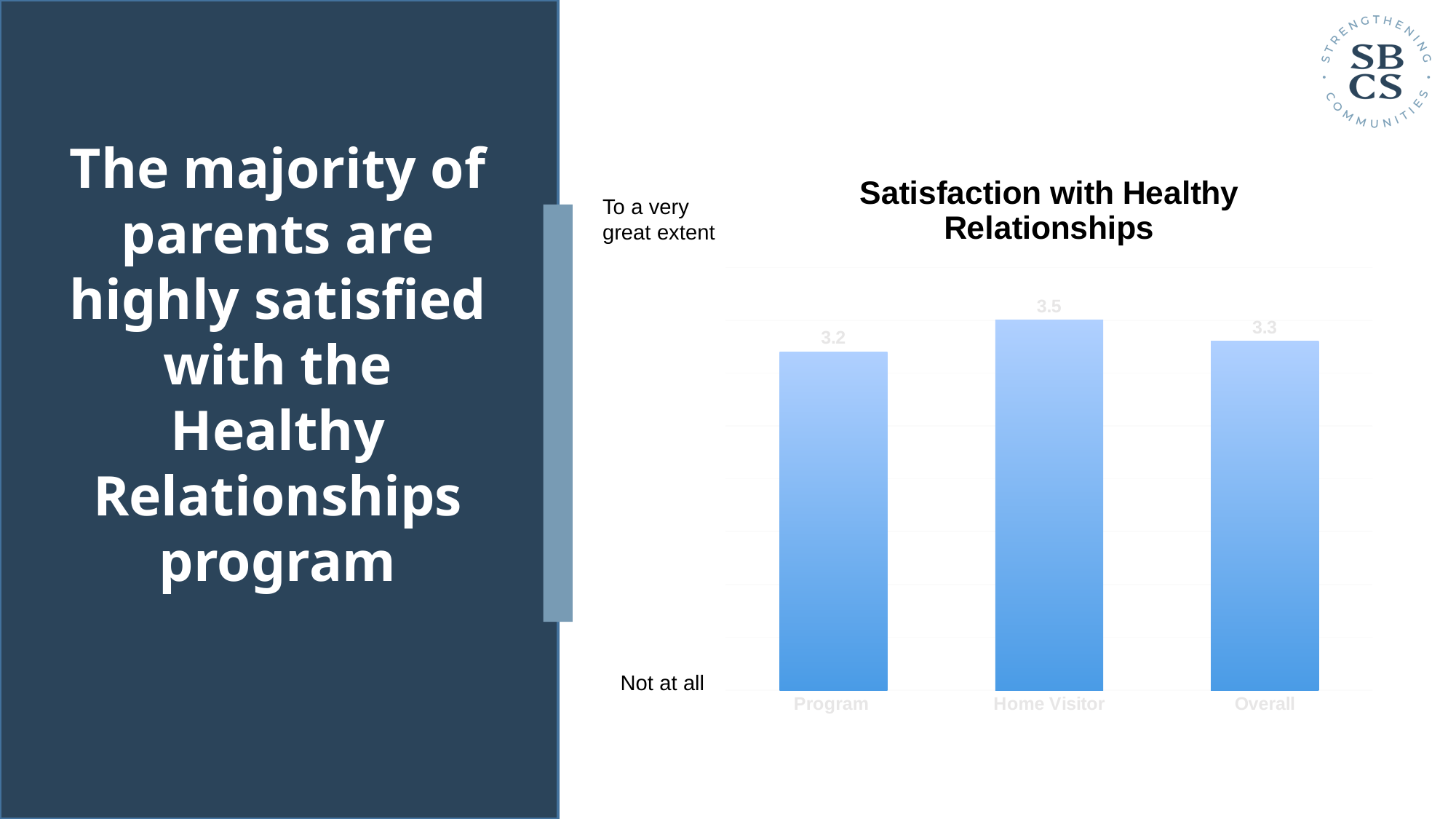
What is the value for Overall in the Satisfaction with Healthy Relationships chart? 3.3 What is the difference between the Home Visitor and Program values in the Satisfaction with Healthy Relationships chart? 0.3 What kind of chart is the Satisfaction with Healthy Relationships chart? Bar chart How many categories are shown in the Satisfaction with Healthy Relationships chart? 3 Which category has the highest value in the Satisfaction with Healthy Relationships chart? Home Visitor What is the value for Program in the Satisfaction with Healthy Relationships chart? 3.2 What label appears at the top of the vertical axis in the Satisfaction with Healthy Relationships chart? To a very great extent What is the title of the chart on the slide? Satisfaction with Healthy Relationships What is the value for Home Visitor in the Satisfaction with Healthy Relationships chart? 3.5 Which is larger in the Satisfaction with Healthy Relationships chart, the value for Home Visitor or the value for Overall? Home Visitor What is the difference between the Overall and Program values in the Satisfaction with Healthy Relationships chart? 0.1 Which category has the lowest value in the Satisfaction with Healthy Relationships chart? Program